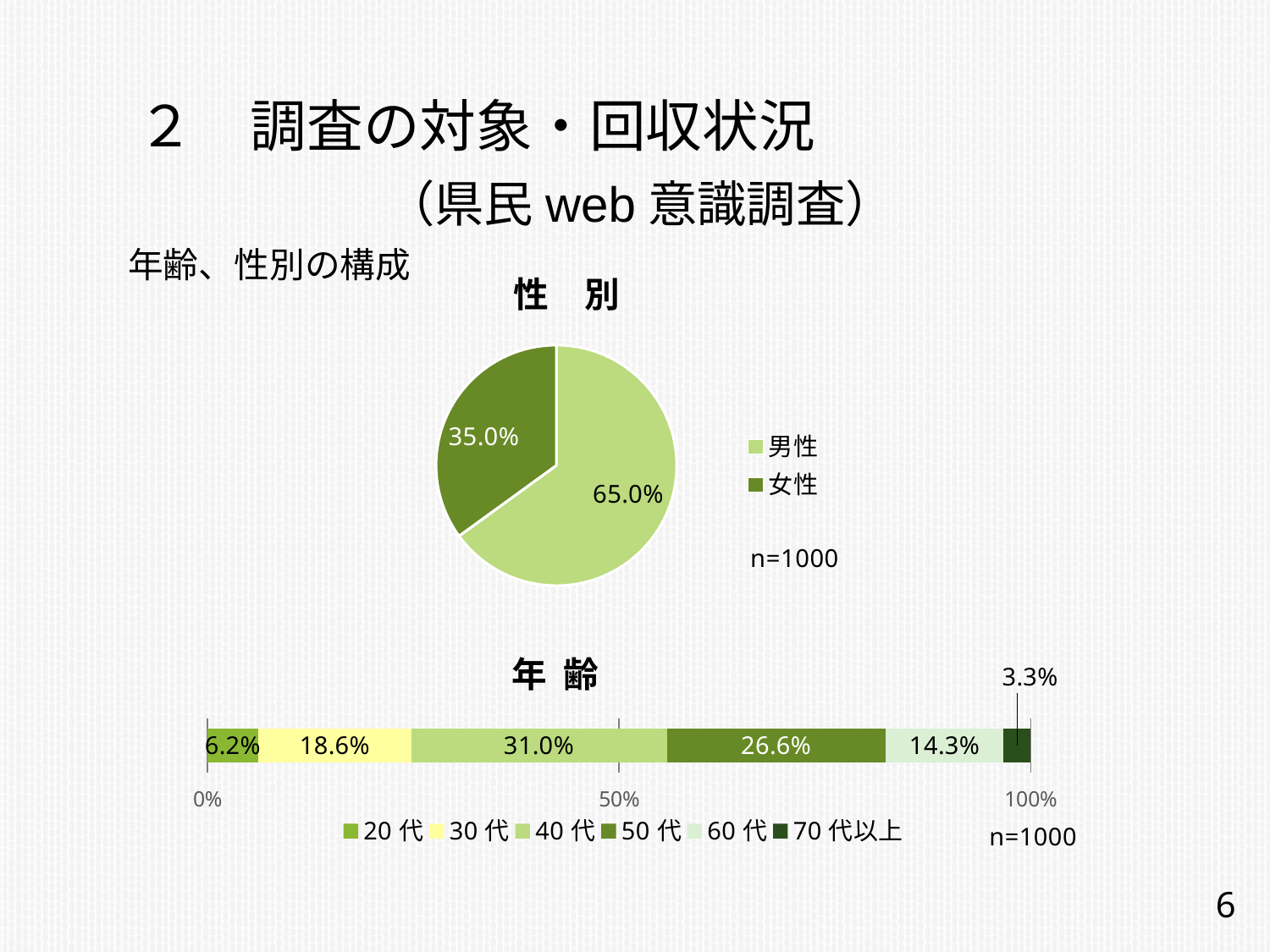
In the 年齢 chart, what is the value for 40代? 31.0% In the 年齢 chart, which age group has the lowest value? 70代以上 In the 年齢 chart, what is the value for 70代以上? 3.3% In the 性別 pie chart, what share is 女性? 35.0% What kind of chart is the 年齢 chart? stacked bar chart In the 性別 pie chart, what share is 男性? 65.0% In the 年齢 chart, what is the difference between the values for 50代 and 60代? 12.3% In the 性別 pie chart, which slice is larger, 男性 or 女性? 男性 In the 年齢 chart, which age group has the highest value? 40代 How many series does the legend of the 年齢 chart list? 6 In the 性別 pie chart, what is the difference between the 男性 and 女性 shares? 30.0% What kind of chart is the 性別 chart? pie chart